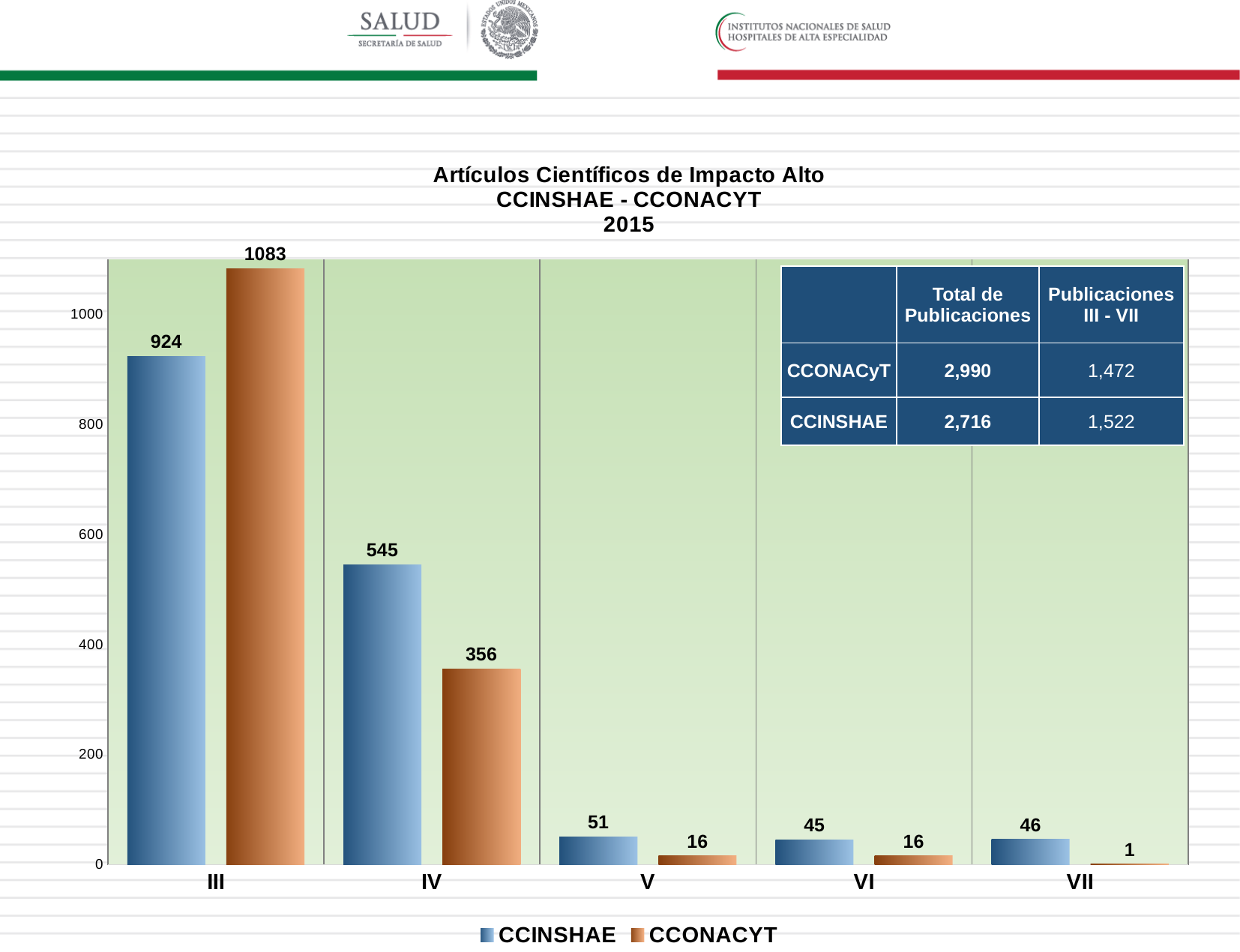
Which category has the lowest CCINSHAE value? VI What is the CCONACYT value for category IV? 356 Do the CCINSHAE values generally rise or fall from category III to category VII? fall What is the CCINSHAE value for category III? 924 How many series does the legend list? 2 What kind of chart is shown? bar chart Which is larger for category V, CCINSHAE or CCONACYT? CCINSHAE What is the difference between the CCONACYT and CCINSHAE values for category III? 159 What is the CCONACYT value for category VII? 1 Which category has the highest CCONACYT value? III How many categories are shown on the x axis? 5 What is the difference between the CCINSHAE and CCONACYT values for category IV? 189